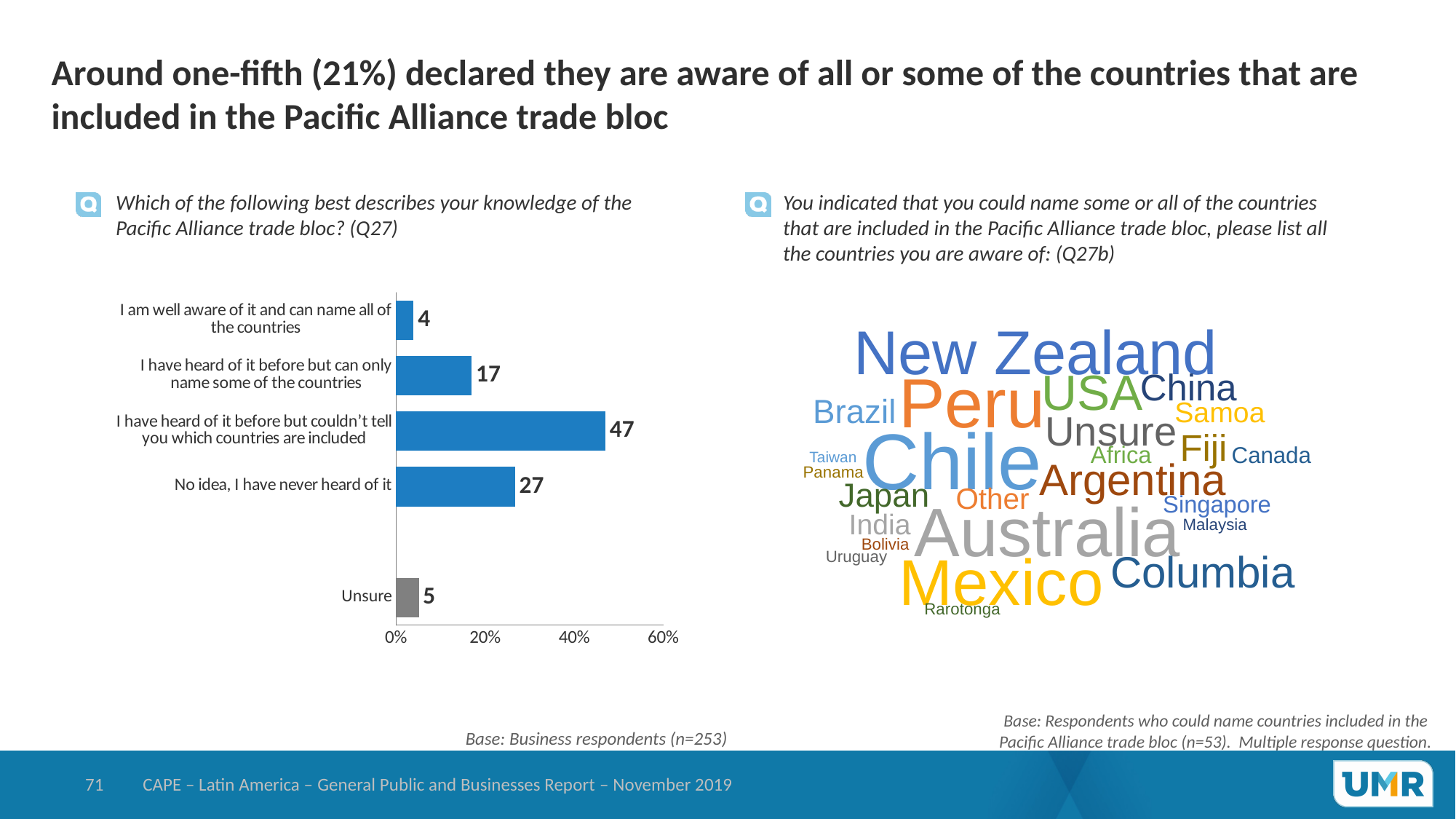
In the bar chart on the left, which category has the lowest value? I am well aware of it and can name all of the countries In the bar chart on the left, what is the difference between "I have heard of it before but couldn't tell you which countries are included" and "No idea, I have never heard of it"? 20 In the bar chart on the left, is the value for "I have heard of it before but couldn't tell you which countries are included" greater or less than 40%? greater In the bar chart on the left, what is the total of "I am well aware of it and can name all of the countries" and "I have heard of it before but can only name some of the countries"? 21 What kind of chart is shown on the left of the slide? bar chart In the bar chart on the left, which category has the highest value? I have heard of it before but couldn't tell you which countries are included In the bar chart on the left, what is the value for "No idea, I have never heard of it"? 27 In the bar chart on the left, what is the value for "I am well aware of it and can name all of the countries"? 4 In the bar chart on the left, what is the value for "Unsure"? 5 In the bar chart on the left, what is the value for "I have heard of it before but couldn't tell you which countries are included"? 47 In the bar chart on the left, which is larger: "I have heard of it before but can only name some of the countries" or "No idea, I have never heard of it"? No idea, I have never heard of it How many categories are shown in the bar chart on the left? 5